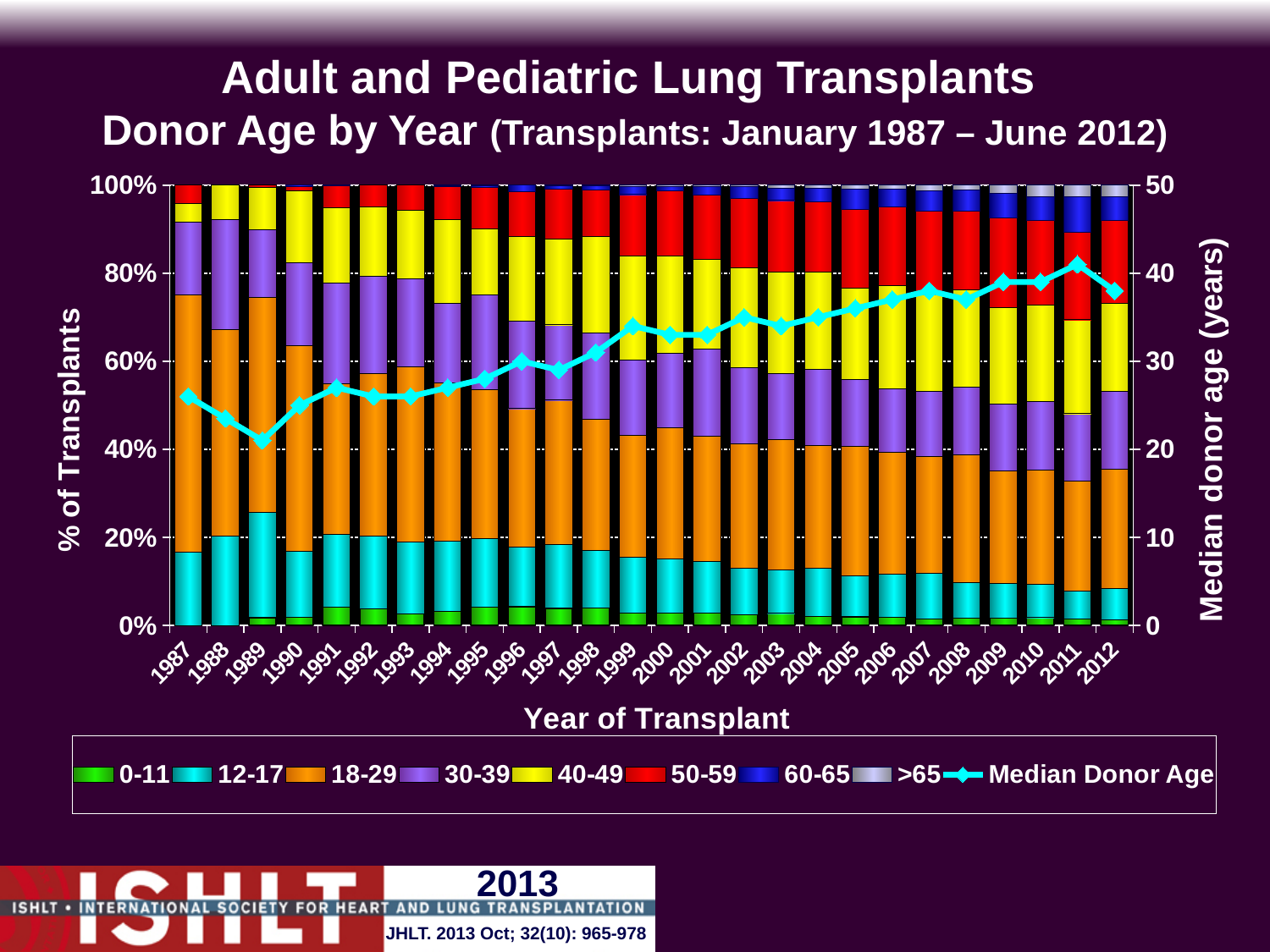
Which colour represents the 40-49 donor age group in the legend? Yellow Is the median donor age for 2011 greater or less than 30 years? greater How many years are shown along the x axis of the chart? 26 How many series does the legend list? 9 What is the title of the right-hand y axis? Median donor age (years) In which year is the median donor age highest? 2011 Does the median donor age generally rise or fall from 1987 to 2012? rise Is the median donor age for 1989 greater or less than 30 years? less What kind of chart is shown on the slide? Stacked bar chart with a line In which year is the median donor age lowest? 1989 Is the median donor age for 1987 greater or less than 30 years? less Which year has a higher median donor age, 1990 or 2005? 2005